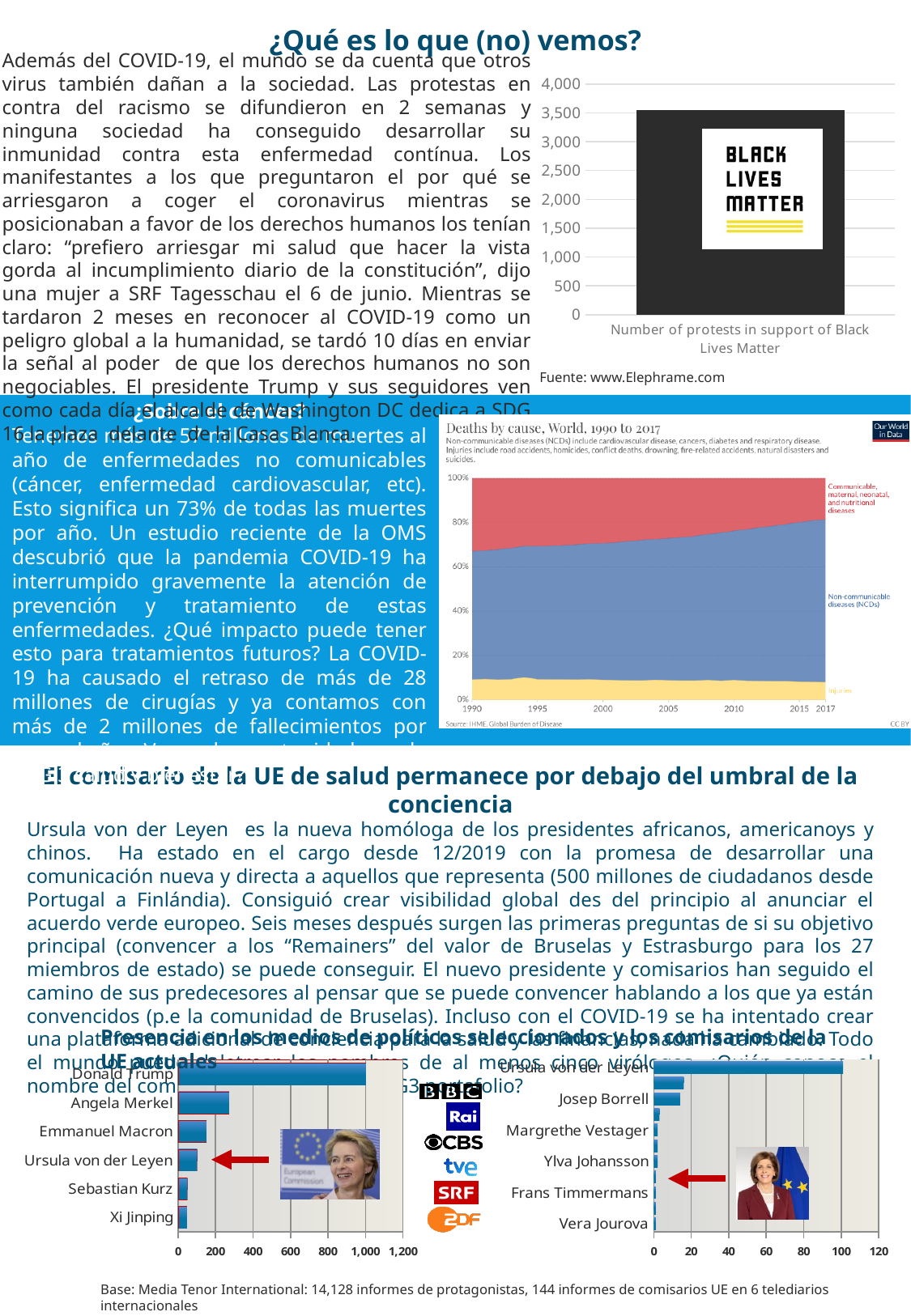
In the 'Deaths by cause, World, 1990 to 2017' chart, is the share of injuries in 2017 greater or less than 20%? less In the 'Deaths by cause, World, 1990 to 2017' chart, does the share of non-communicable diseases (NCDs) rise or fall from 1990 to 2017? rise In the 'Deaths by cause, World, 1990 to 2017' chart, is the share of non-communicable diseases (NCDs) in 2017 greater or less than 60%? greater What is the title of the chart in the middle of the slide from Our World in Data? Deaths by cause, World, 1990 to 2017 In the bottom-left chart of media presence of selected politicians, which person has the highest value? Donald Trump In the 'Deaths by cause, World, 1990 to 2017' chart, how many cause categories are plotted? 3 In the bottom-left chart of media presence of selected politicians, is the value for Donald Trump greater or less than 800? greater What type of chart is the 'Number of protests in support of Black Lives Matter' chart at the top right of the slide? bar chart In the bottom-left chart of media presence of selected politicians, who has the larger value, Angela Merkel or Emmanuel Macron? Angela Merkel In the bottom-left chart of media presence of selected politicians, how many people are listed? 6 In the bottom-right chart of media presence of current EU commissioners, which commissioner has the highest value? Ursula von der Leyen